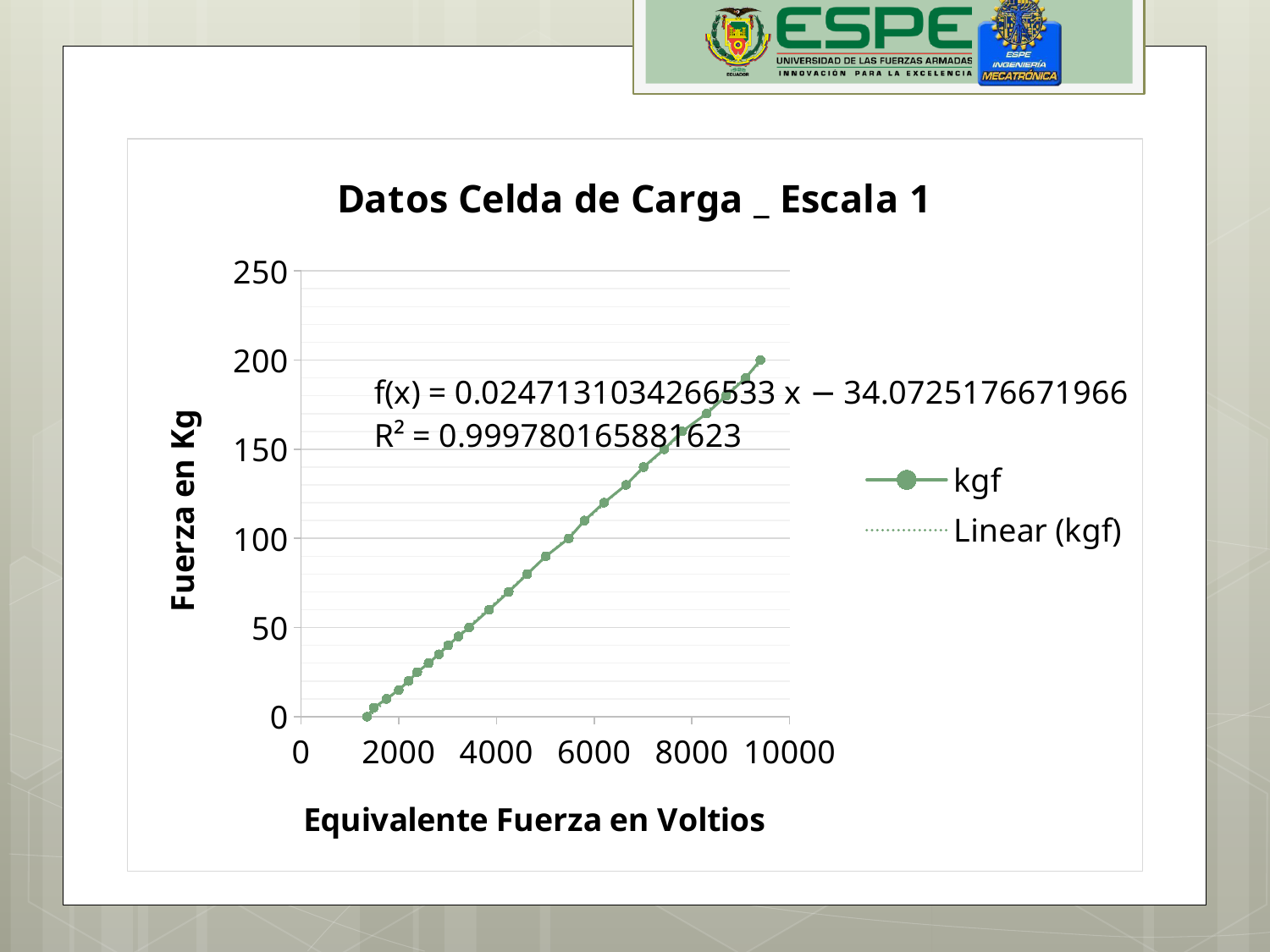
Is the kgf value at about 4000 on the x axis greater or less than 100? less What is the title of the chart? Datos Celda de Carga _ Escala 1 How many series does the chart legend list? 2 What kind of chart is shown on the slide? line chart Is the highest plotted kgf value greater or less than 150? greater Do the kgf values rise or fall as the x-axis value (Equivalente Fuerza en Voltios) increases? rise What is the R² value shown on the chart? 0.999780165881623 Is the kgf value at about 6000 on the x axis greater or less than 100? greater